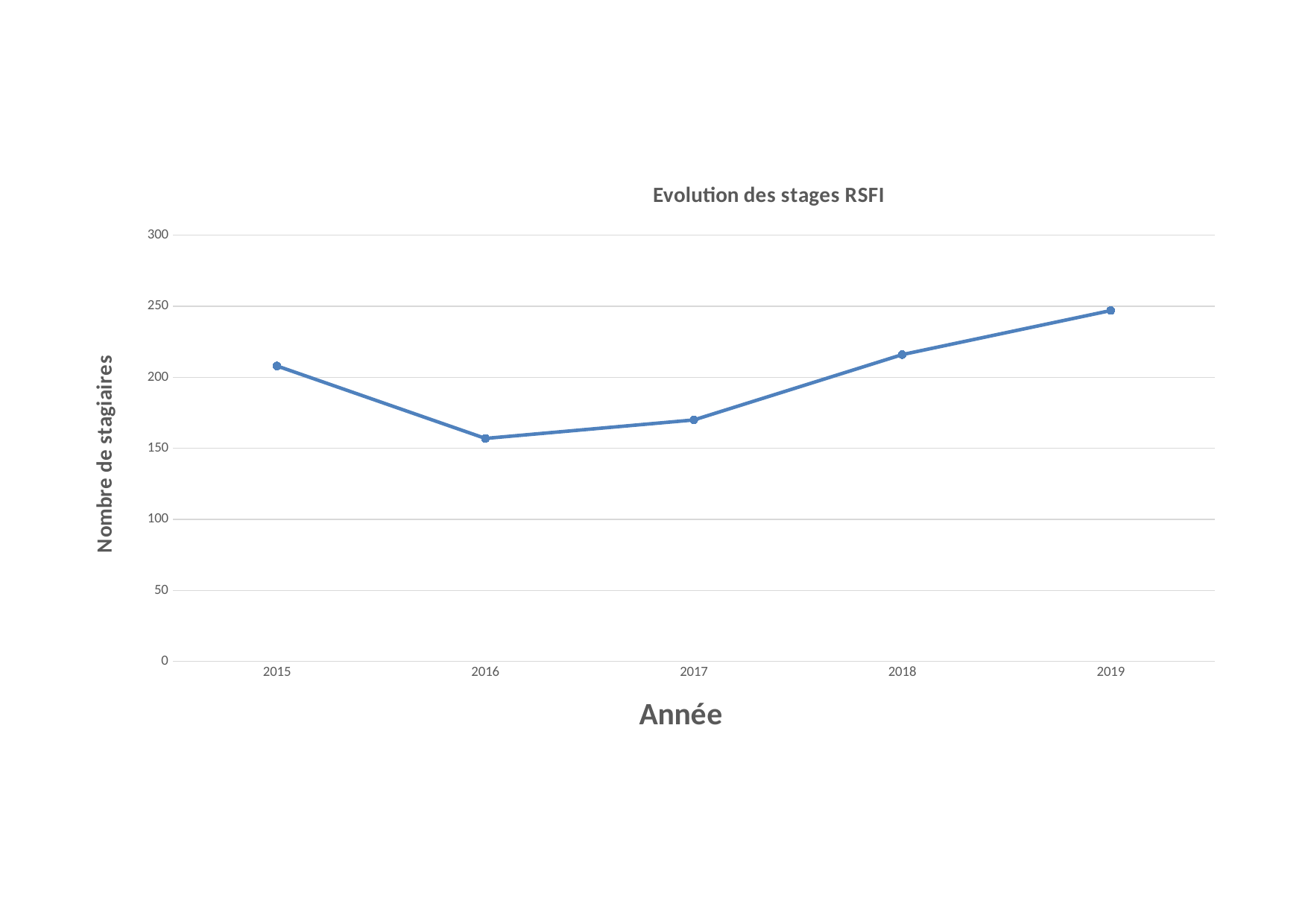
How many years are plotted on the x axis? 5 Which year has a larger value, 2015 or 2017? 2015 What is the title of the chart? Evolution des stages RSFI Do the values rise or fall from 2016 to 2019? rise Is the value for 2017 greater or less than 150? greater What kind of chart is shown on the slide? line chart Is the value for 2019 greater or less than 200? greater Is the value for 2015 greater or less than 250? less Which year has the lowest number of stagiaires? 2016 Which year has the highest number of stagiaires? 2019 What is the label of the y axis? Nombre de stagiaires